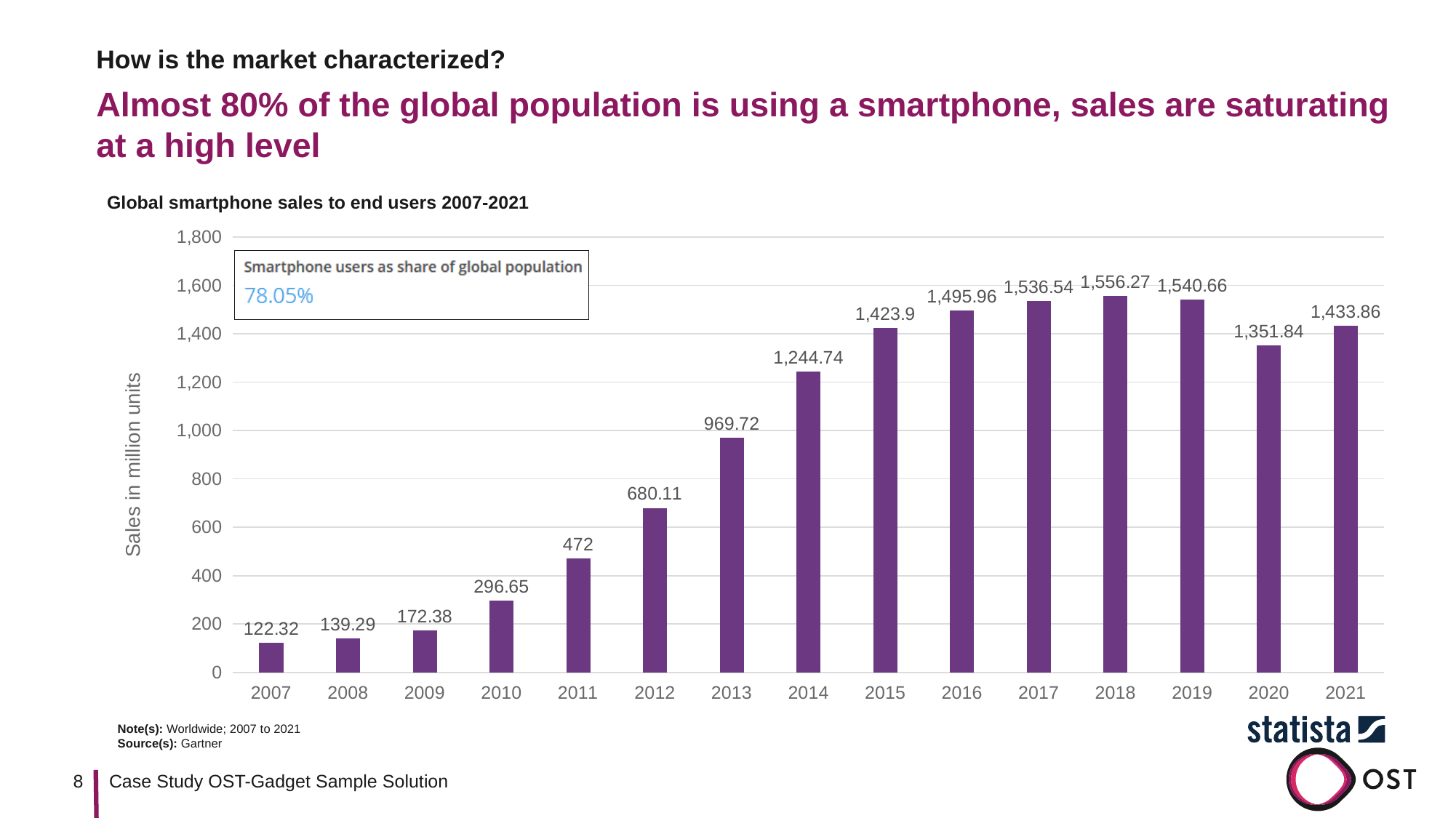
What is the difference between the 2021 and 2020 values? 82.02 Which year had higher sales, 2013 or 2012? 2013 Do sales rise or fall from 2007 to 2018? Rise How many years are shown on the x axis? 15 What is the chart's title? Global smartphone sales to end users 2007-2021 What value is shown for 2011? 472 What were global smartphone sales to end users in 2014? 1,244.74 Which year has the highest smartphone sales? 2018 What kind of chart is this? Bar chart Which year has the lowest smartphone sales? 2007 Is the value for 2015 greater or less than 1,400? greater What were global smartphone sales in 2020? 1,351.84